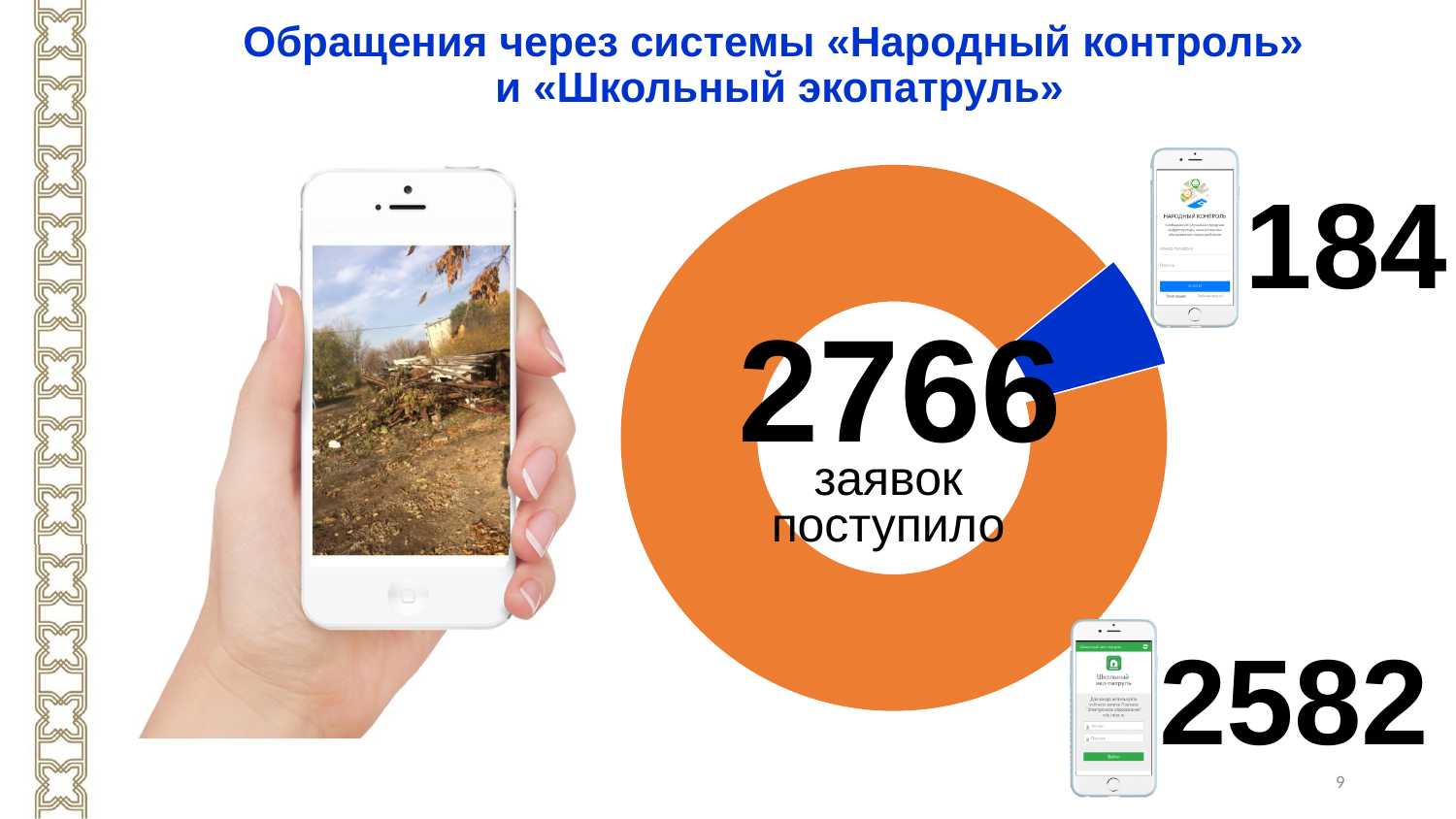
What kind of chart is shown on the slide? Pie chart (donut) Which system received the smaller number of requests? Народный контроль What colour is the slice representing the 184 requests? Blue What colour is the slice representing the 2582 requests? Orange What total number of requests (заявок) is shown in the centre of the donut chart? 2766 How many requests came through the «Народный контроль» system? 184 Which system received the larger number of requests? Школьный экопатруль What is the difference between the number of requests via «Школьный экопатруль» and via «Народный контроль»? 2398 Is the value for «Народный контроль» larger or smaller than the value for «Школьный экопатруль»? Smaller How many requests came through the «Школьный экопатруль» system? 2582 How many slices does the donut chart have? 2